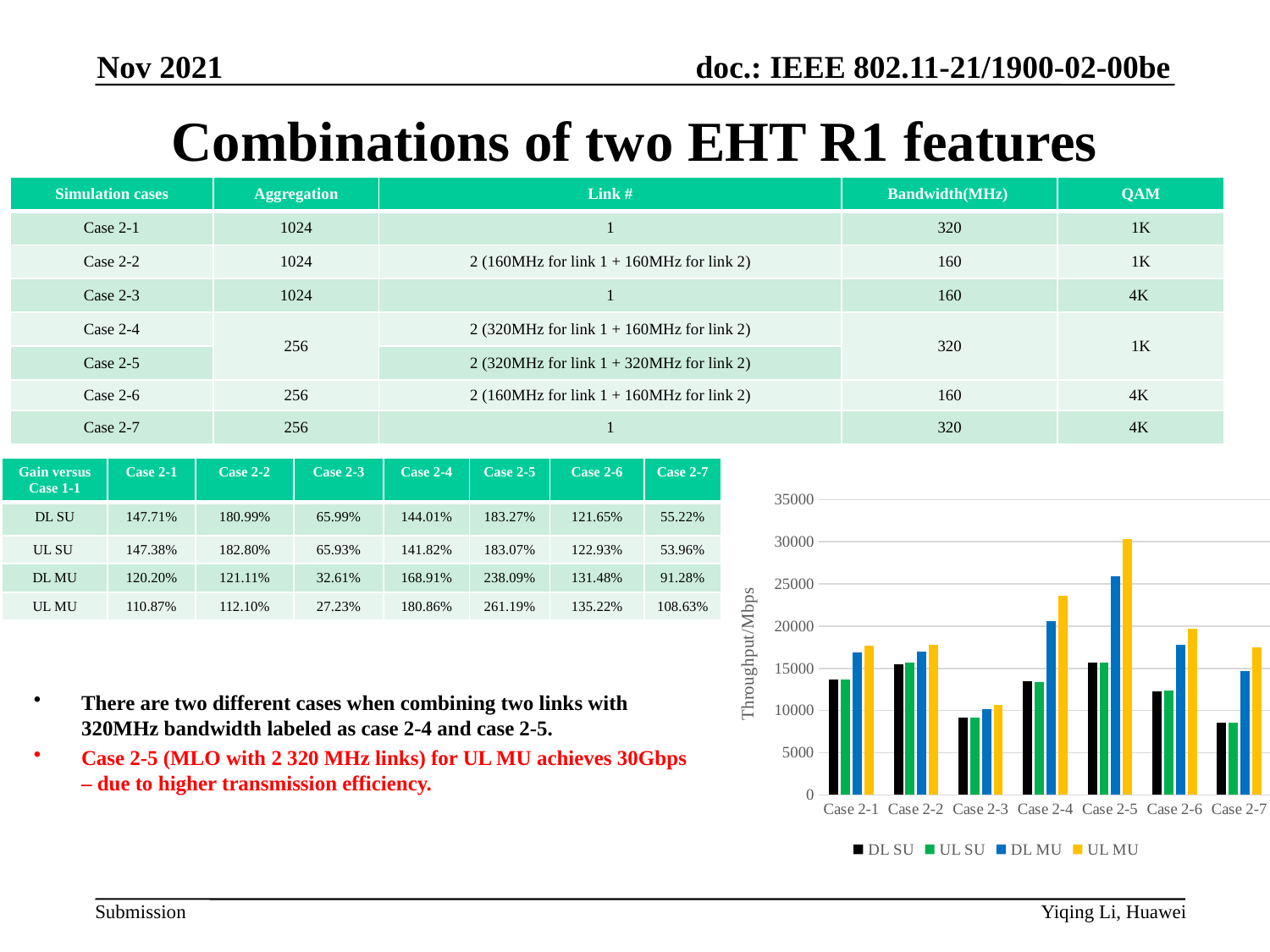
Is the UL MU throughput for Case 2-5 greater or less than 25000? greater Which series is shown in yellow in the chart? UL MU Which case has the lowest UL MU throughput in the chart? Case 2-3 Which is larger, the UL MU throughput for Case 2-4 or for Case 2-6? Case 2-4 How many series does the chart legend list? 4 Which case has the highest UL MU throughput in the chart? Case 2-5 How many simulation cases are shown along the x axis of the chart? 7 Is the DL SU throughput for Case 2-3 greater or less than 10000? less Is the UL MU throughput for Case 2-4 greater or less than 20000? greater What kind of chart is shown on the slide? bar chart Which case has the highest DL MU throughput in the chart? Case 2-5 What is the label of the vertical axis of the chart? Throughput/Mbps